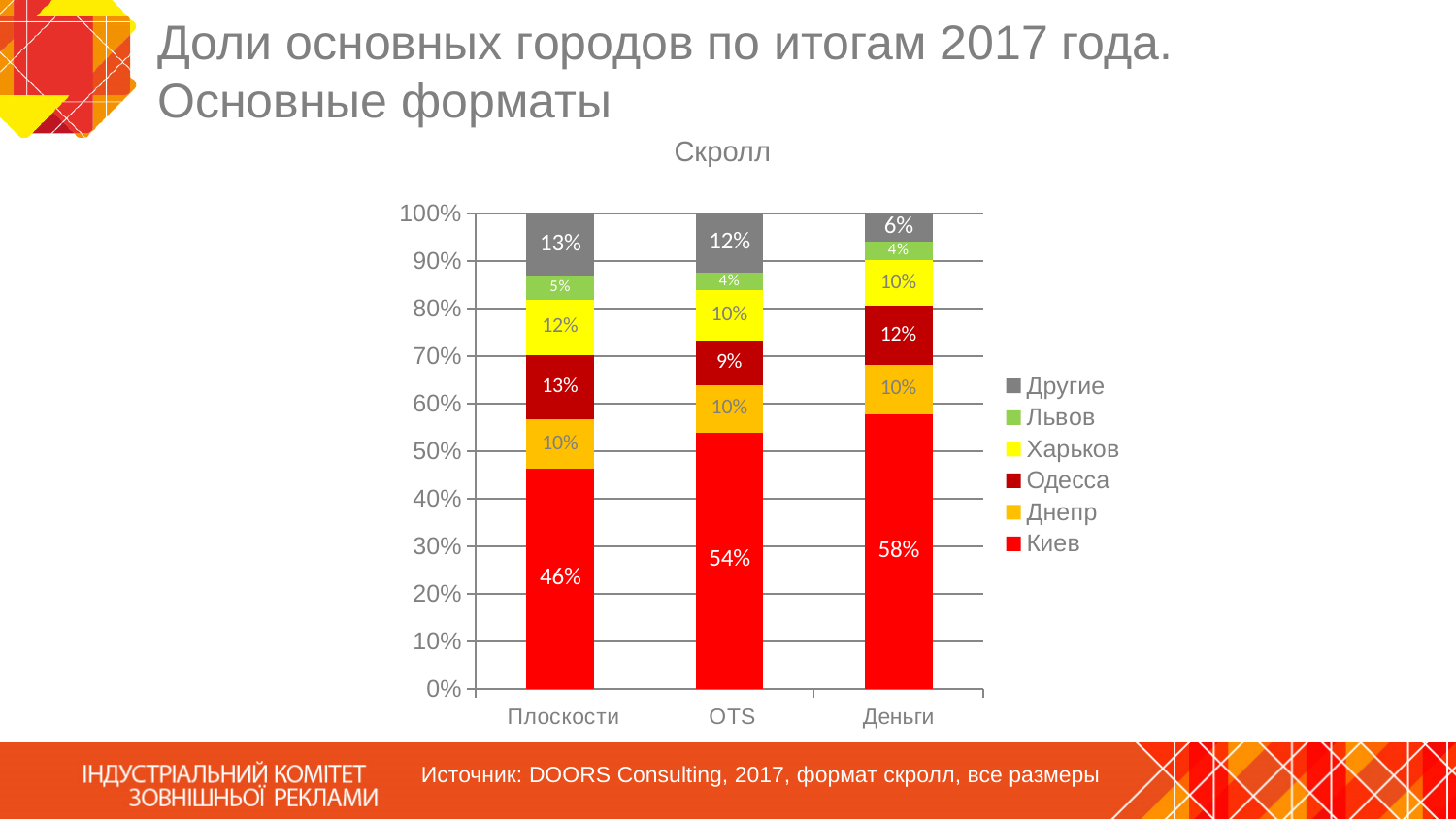
What kind of chart is shown on the slide? Stacked bar chart How many categories are shown on the x axis? 3 Which is larger: the Одесса value for Плоскости or the Одесса value for OTS? Плоскости What is the difference between the Киев value for Деньги and the Киев value for Плоскости? 12% What is the value for Киев in the Плоскости bar? 46% What is the value for Одесса in the OTS bar? 9% In which category is the Киев share highest? Деньги How many series does the legend list? 6 What is the value for Другие in the Деньги bar? 6% In which category is the Другие share lowest? Деньги What is the value for Львов in the Плоскости bar? 5% What is the title of the chart? Скролл